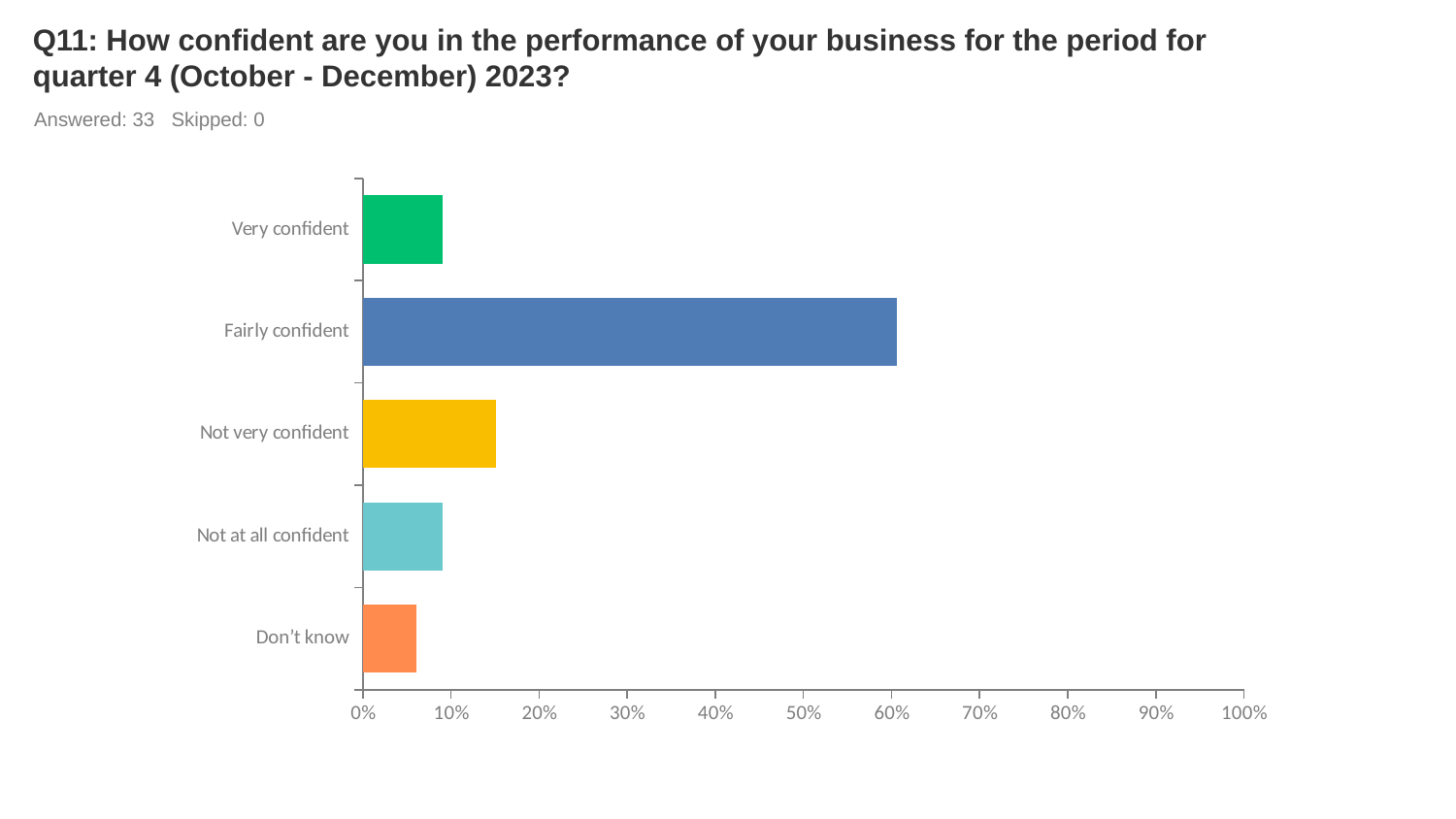
Is the value for Fairly confident greater or less than 50%? greater How many respondents answered the question according to the slide? 33 Is the value for Very confident greater or less than 10%? less Is the value for Not very confident greater or less than 10%? greater Which is larger, the value for Fairly confident or the value for Not very confident? Fairly confident Which category has the lowest value? Don't know Which category has the highest value? Fairly confident How many categories are shown on the chart? 5 Which is larger, the value for Not very confident or the value for Very confident? Not very confident What kind of chart is shown on the slide? bar chart